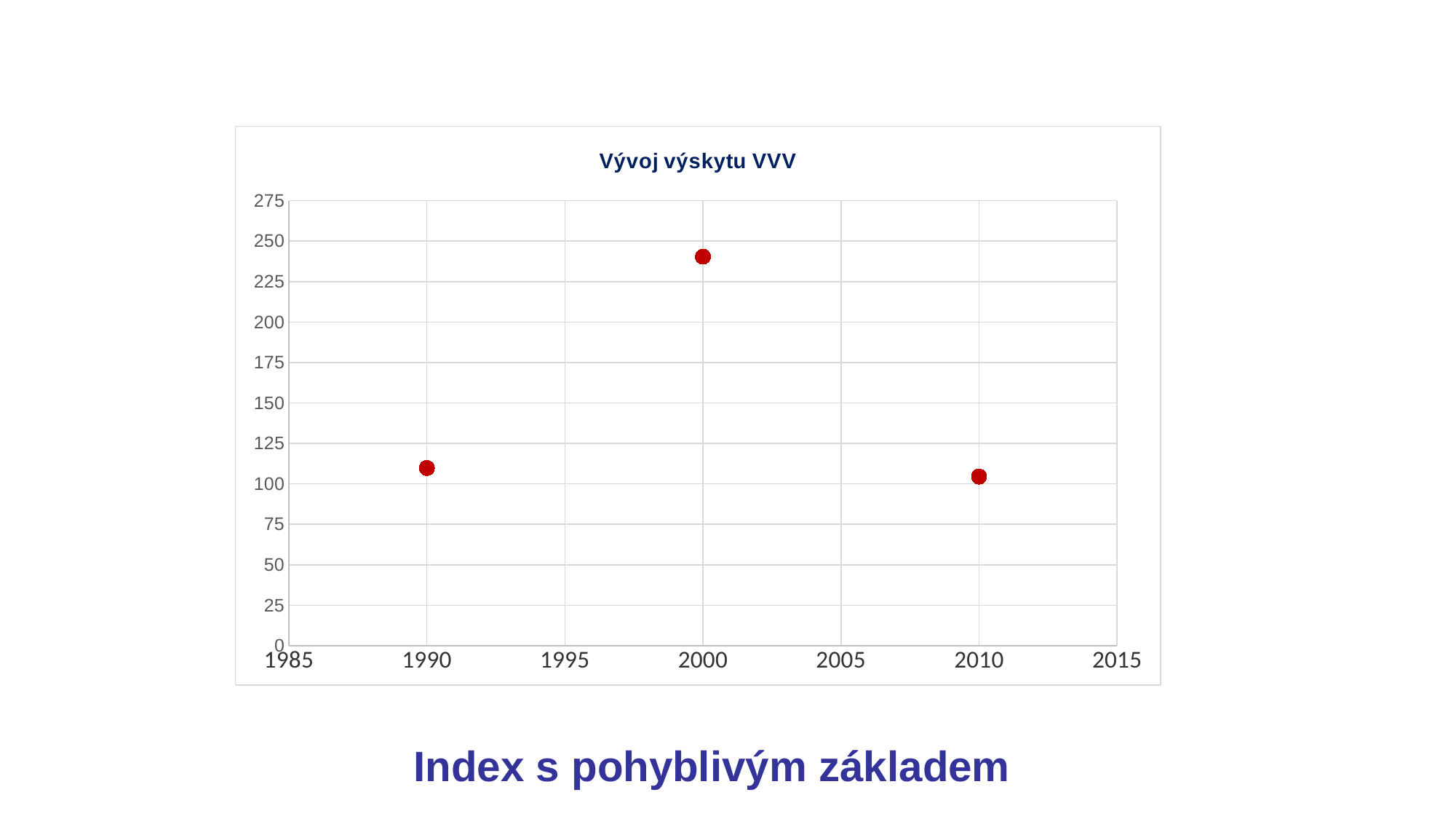
Does the value rise or fall from 2000 to 2010? falls Is the value for 2010 greater or less than 125? less Is the value for 2000 greater or less than 200? greater Which has the larger value, 2000 or 2010? 2000 Is the value for 1990 greater or less than 100? greater Which has the larger value, 1990 or 2000? 2000 How many data points are plotted in the chart? 3 What kind of chart is shown on the slide? scatter chart Does the value rise or fall from 1990 to 2000? rises Which year has the highest value in the chart? 2000 What is the title of the chart? Vývoj výskytu VVV